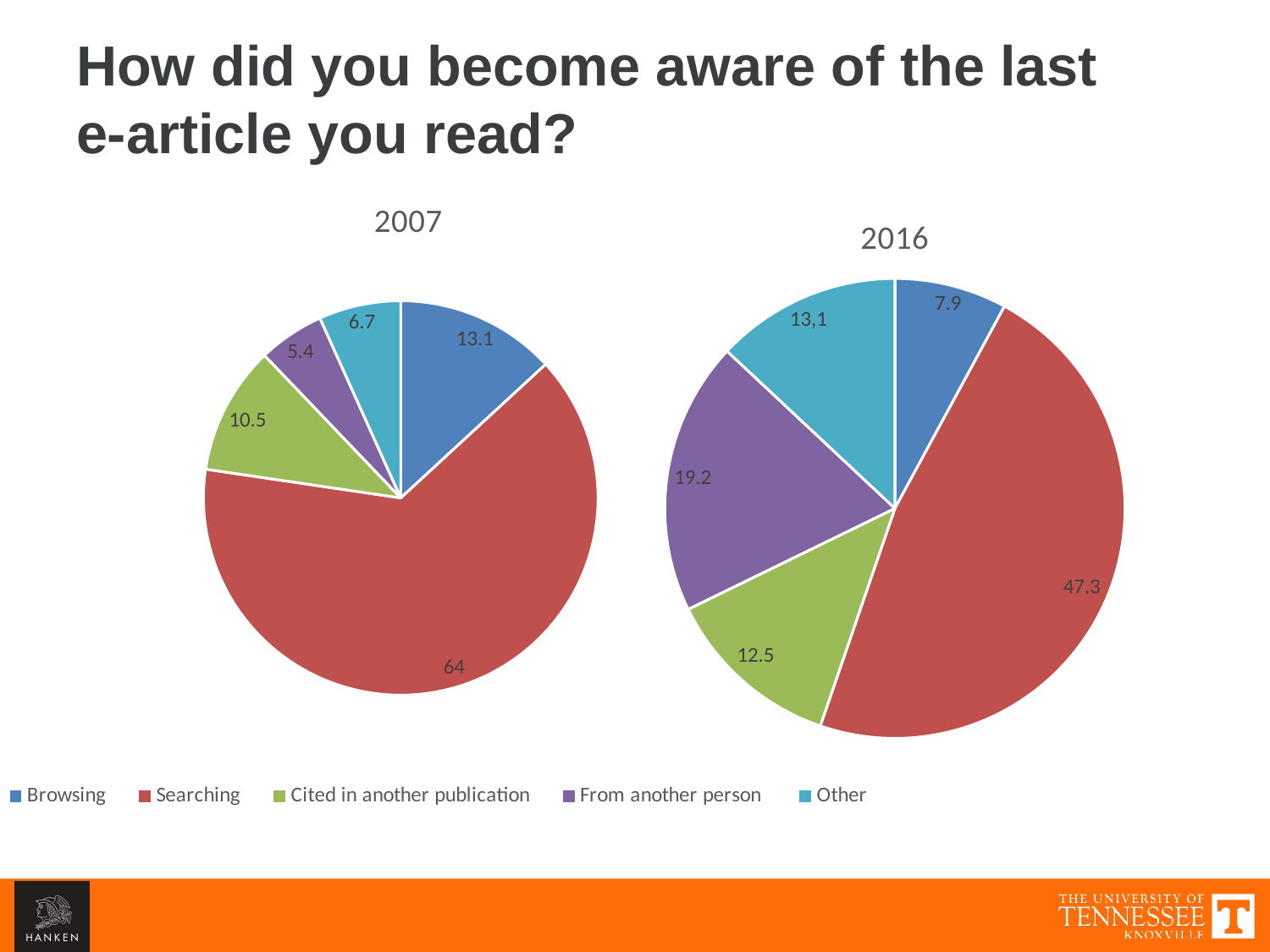
In the 2016 pie chart, which is larger, the value for From another person or the value for Other? From another person How many slices does the 2016 pie chart have? 5 What type of chart is used for the 2007 data? Pie chart How many entries does the legend list? 5 In the 2007 pie chart, what is the value for Browsing? 13.1 In the 2007 pie chart, what is the difference between the values for Searching and Browsing? 50.9 In the 2016 pie chart, what is the value for Cited in another publication? 12.5 In the 2007 pie chart, what is the value for Searching? 64 In the 2016 pie chart, which category has the largest slice? Searching In the 2007 pie chart, which category has the smallest slice? From another person In the 2016 pie chart, which category has the smallest slice? Browsing In the 2016 pie chart, what is the value for From another person? 19.2